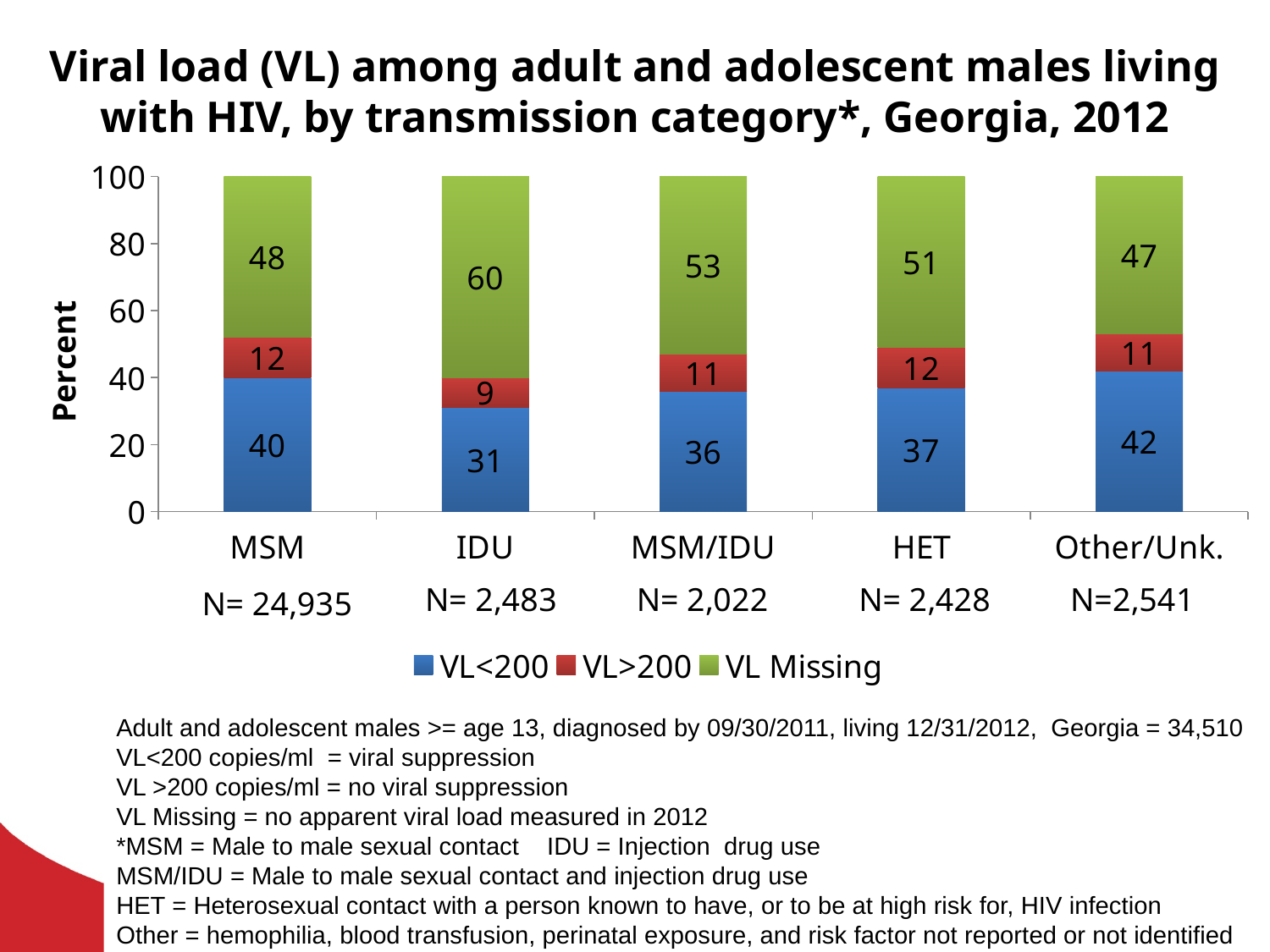
What is the total of the stacked bar for MSM? 100 What kind of chart is shown on the slide? Stacked bar chart Which transmission category has the lowest VL<200 value? IDU How many transmission categories are shown on the x axis? 5 What is the label of the y axis? Percent What is the difference between the VL Missing values for IDU and Other/Unk.? 13 Which is larger, the VL<200 value for HET or for MSM/IDU? HET Which transmission category has the highest VL<200 value? Other/Unk. What is the VL>200 value for HET? 12 What is the VL<200 value for MSM? 40 How many series does the legend list? 3 What is the VL Missing value for IDU? 60